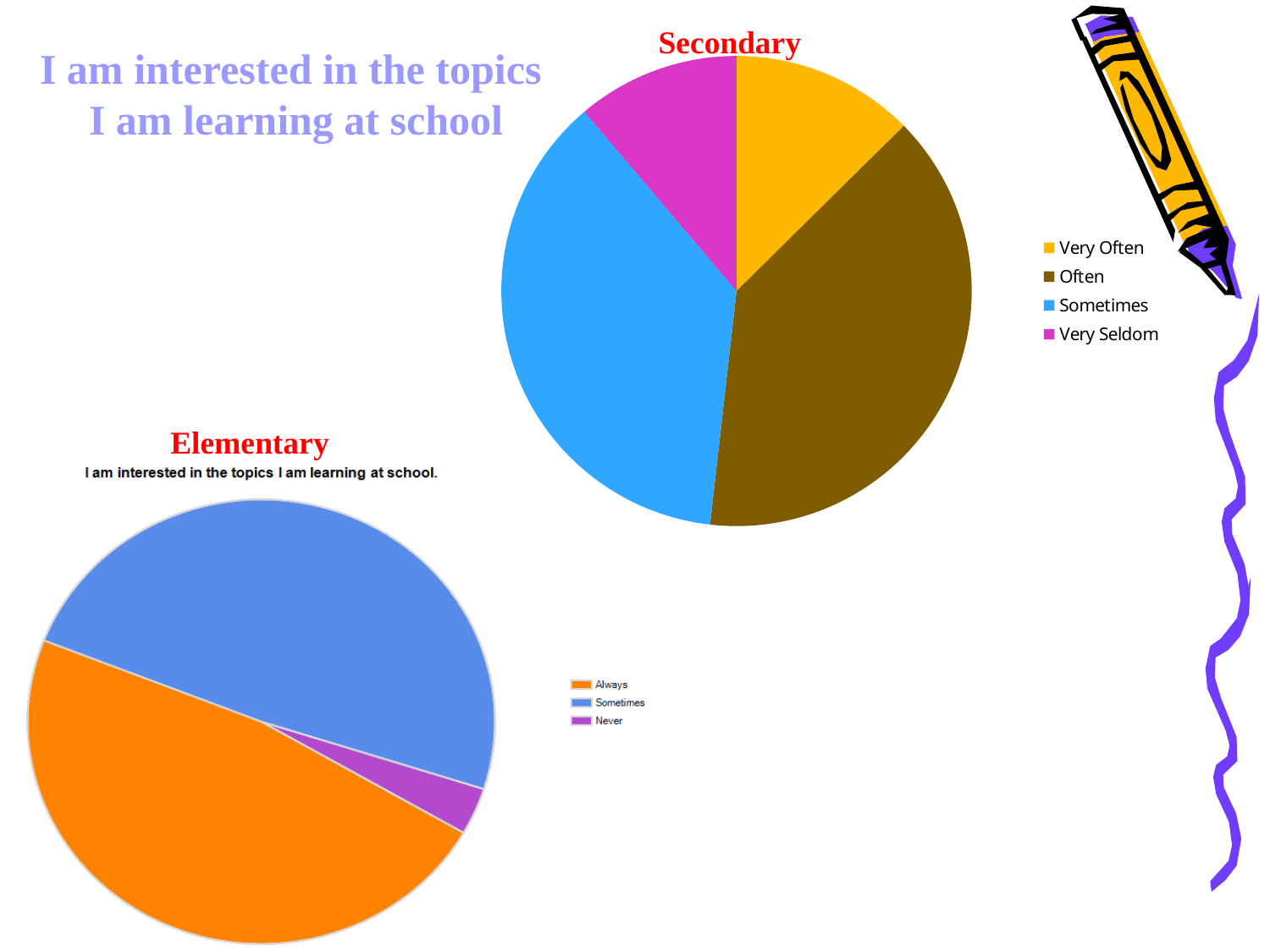
What kind of chart is the Elementary chart? pie chart What is the title printed above the Elementary pie chart? I am interested in the topics I am learning at school. How many entries does the legend of the Elementary chart list? 3 In the Secondary chart, which slice is larger: Sometimes or Very Seldom? Sometimes How many slices does the Elementary pie chart have? 3 What colour is the Sometimes slice in the Secondary chart? blue In the Elementary chart, which category has the smallest slice? Never What kind of chart is the Secondary chart? pie chart How many slices does the Secondary pie chart have? 4 How many entries does the legend of the Secondary chart list? 4 In the Elementary chart, which slice is larger: Always or Never? Always In the Secondary chart, which slice is larger: Often or Very Often? Often